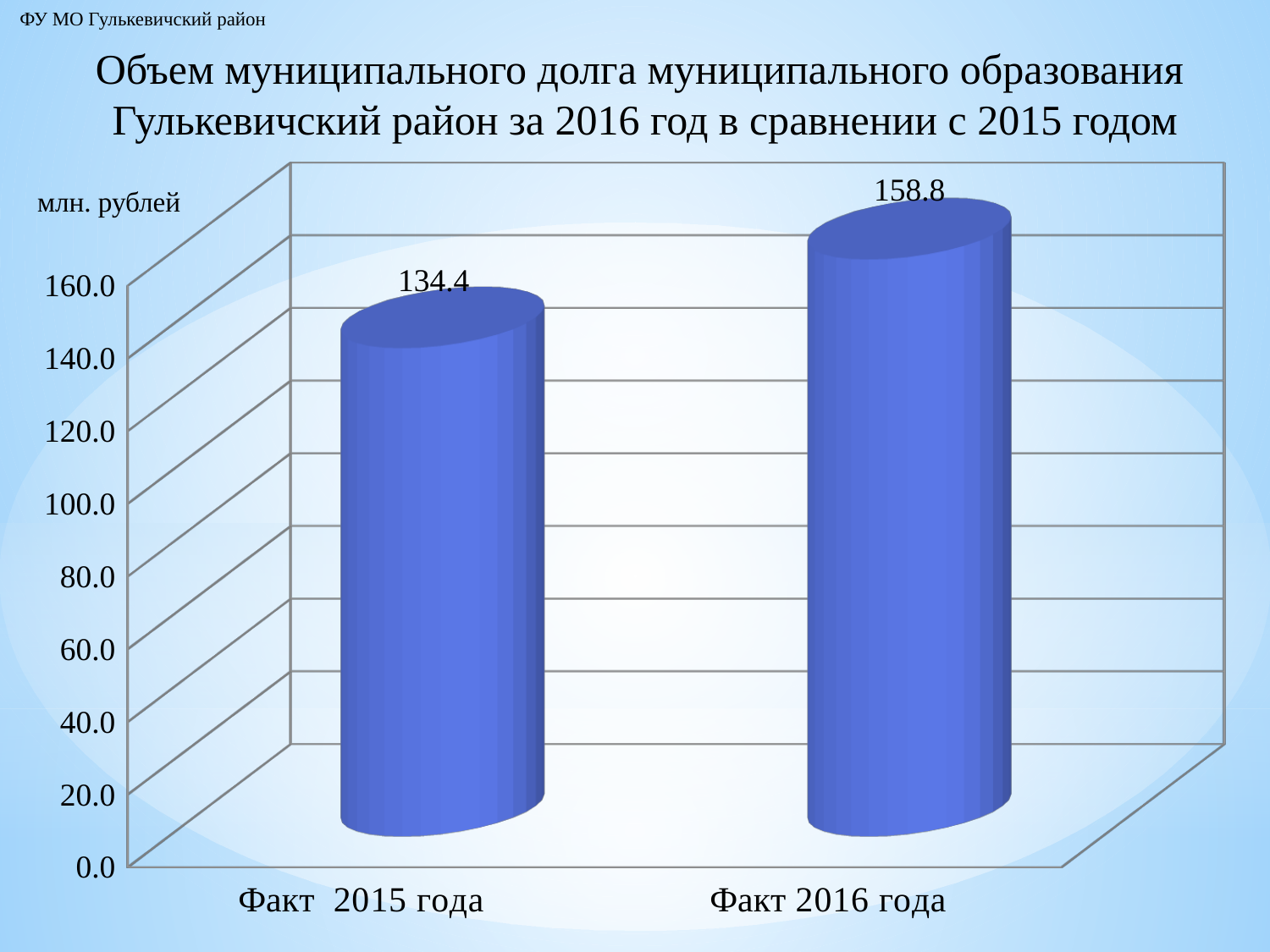
What kind of chart is shown on the slide? bar chart Is the value for Факт 2015 года greater or less than 140.0? less What is the value for Факт 2015 года? 134.4 What is the difference between the values for Факт 2016 года and Факт 2015 года? 24.4 Do the values rise or fall from Факт 2015 года to Факт 2016 года? rise What unit is shown for the values on the chart? млн. рублей Which category has the highest value? Факт 2016 года What is the value for Факт 2016 года? 158.8 Which is larger, the value for Факт 2015 года or Факт 2016 года? Факт 2016 года Is the value for Факт 2016 года greater or less than 140.0? greater How many categories are shown on the chart? 2 Which category has the lowest value? Факт 2015 года